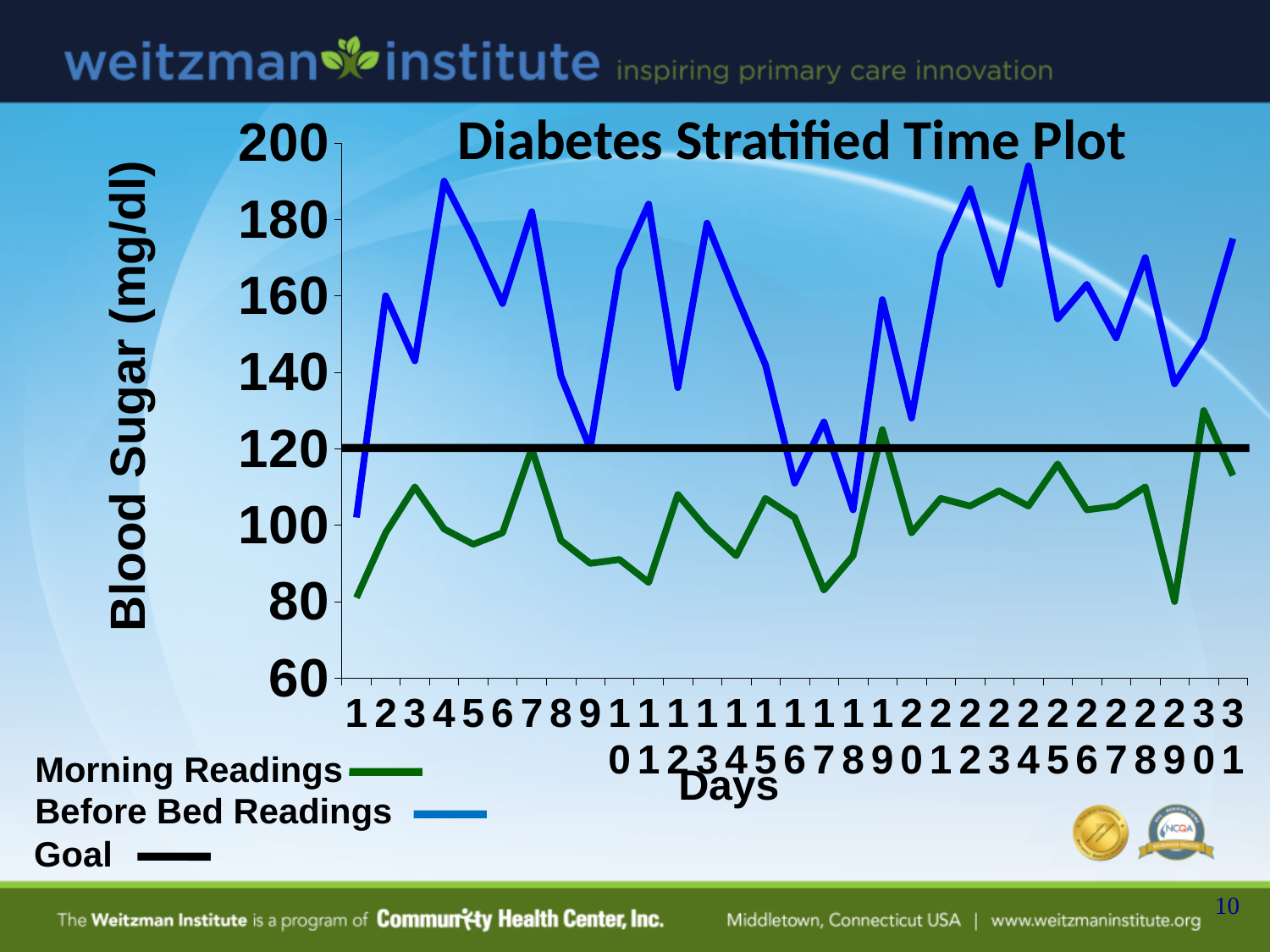
How many days are plotted along the x axis? 31 What is the title of the chart? Diabetes Stratified Time Plot What value does the Goal line sit at? 120 On day 4, which is higher, the Morning Reading or the Before Bed Reading? Before Bed Reading Is the Morning Reading on day 1 greater or less than 100? less Is the Before Bed Reading on day 1 greater or less than 120? less What is the label of the vertical axis? Blood Sugar (mg/dl) How many series does the legend list? 3 Is the Morning Reading on day 29 greater or less than 100? less What kind of chart is shown on the slide? line chart